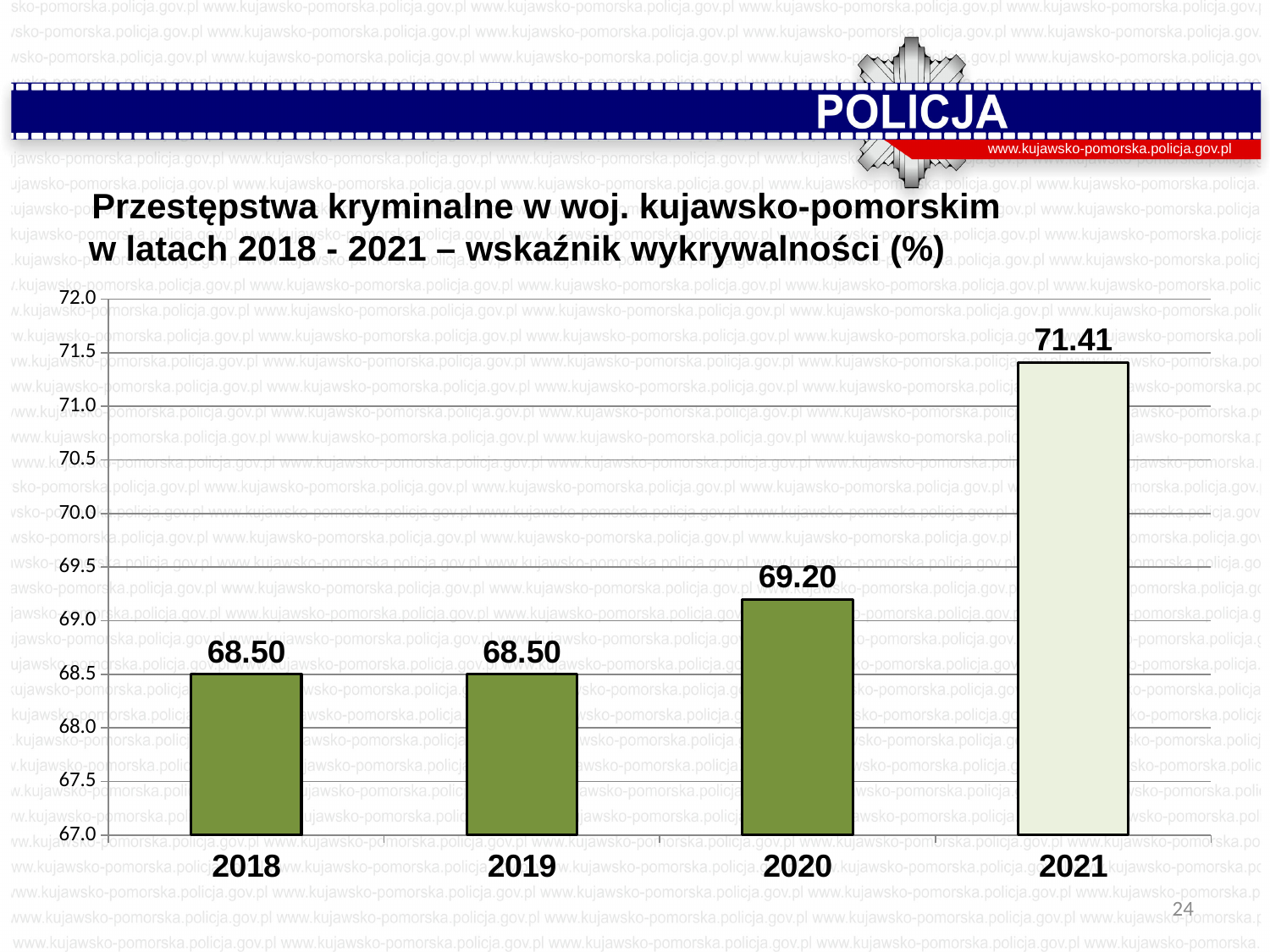
What is the value shown for 2020? 69.20 What is the detection rate value shown for 2021? 71.41 What kind of chart is shown on the slide? bar chart Is the value for 2018 greater or less than 69.0? less What is the difference between the values for 2020 and 2019? 0.70 Is the value for 2021 greater or less than 71.0? greater How many years are shown on the x axis? 4 What is the value shown for 2018? 68.50 What is the difference between the values for 2021 and 2020? 2.21 Which year has the highest value? 2021 Do the values rise or fall from 2019 to 2021? rise Which is larger, the value for 2020 or the value for 2019? 2020